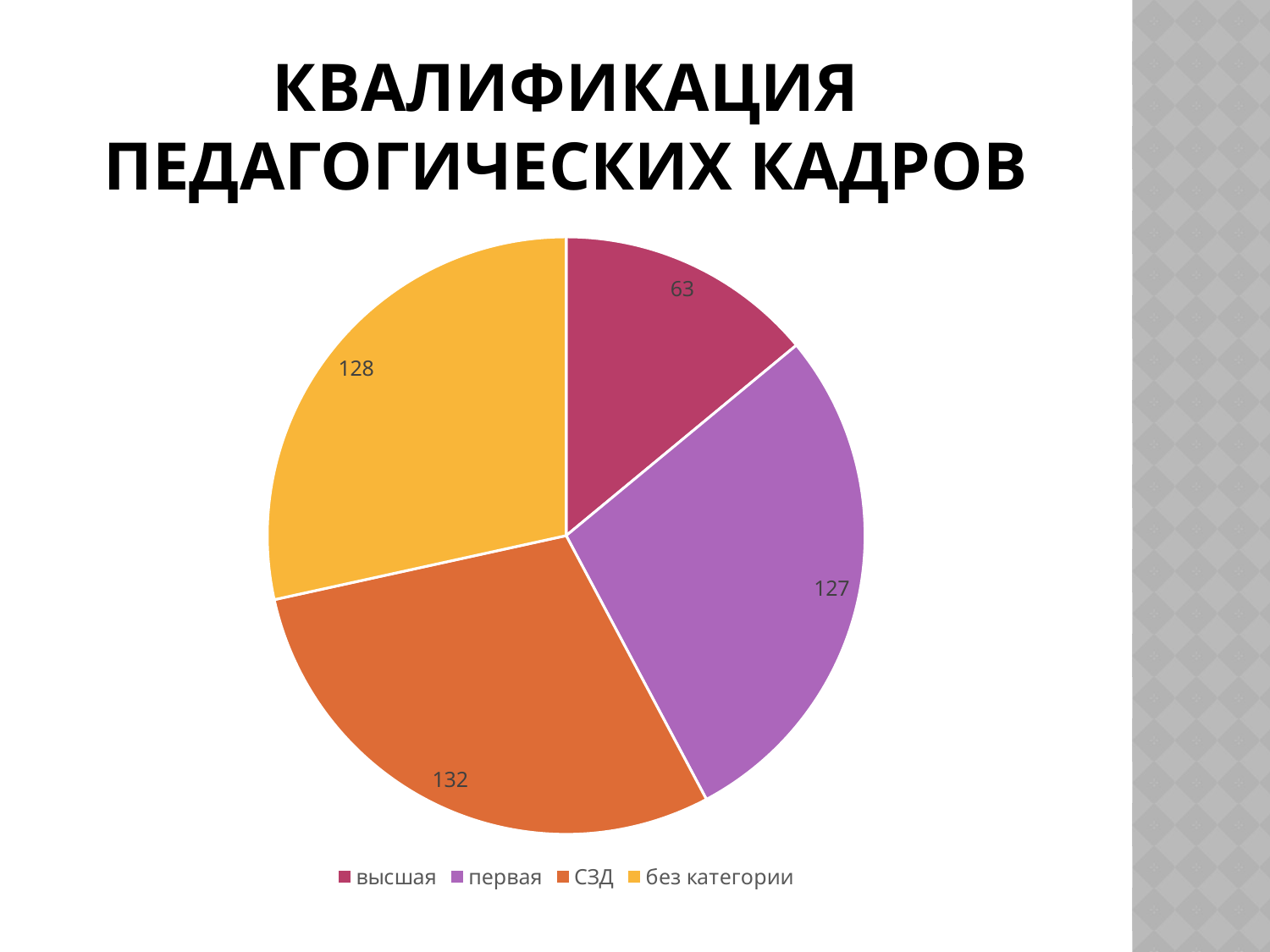
What is the difference between the values for СЗД and высшая? 69 What is the title of the chart? КВАЛИФИКАЦИЯ ПЕДАГОГИЧЕСКИХ КАДРОВ What value is shown for the высшая slice? 63 What value is shown for the СЗД slice? 132 Which category has the largest slice? СЗД What value is shown for the без категории slice? 128 What kind of chart is shown on the slide? pie chart Which is larger, the value for первая or the value for высшая? первая Which category has the smallest slice? высшая What value is shown for the первая slice? 127 What share of the pie does the высшая slice represent? 14% How many categories does the pie chart show? 4